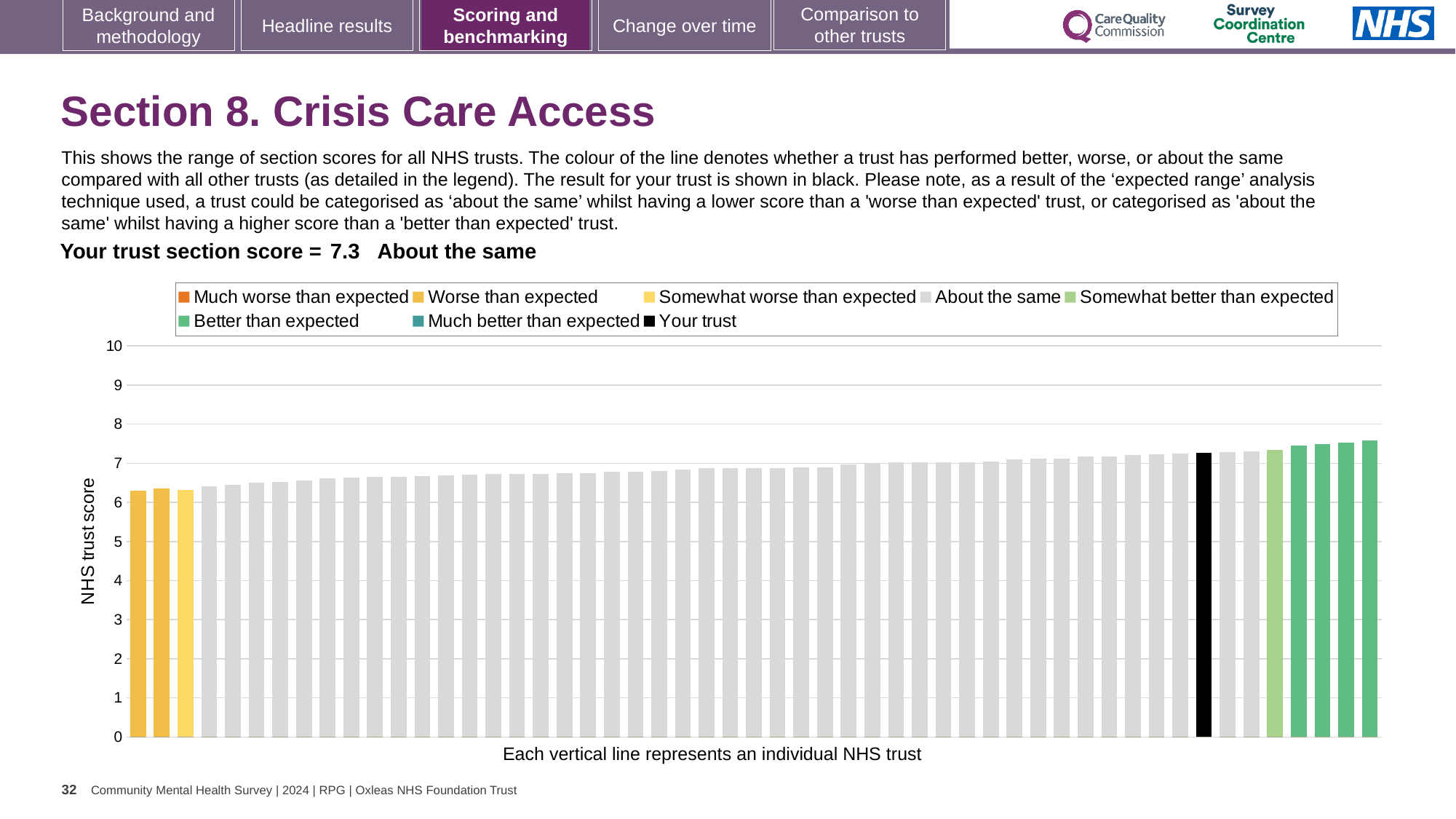
Do the bar values rise or fall from left to right along the x axis? rise What kind of chart is shown on the slide? bar chart How many bars are coloured as 'Better than expected'? 4 Which category is your trust placed in for this section? About the same How many bars are coloured as 'Worse than expected'? 2 How many entries does the chart legend list? 8 What colour is the bar representing your trust? black Is the value of the shortest bar greater or less than 7? less What is the section score for your trust? 7.3 Is the value of the shortest bar greater or less than 6? greater What is the label on the vertical axis of the chart? NHS trust score Is the value of the tallest bar greater or less than 8? less